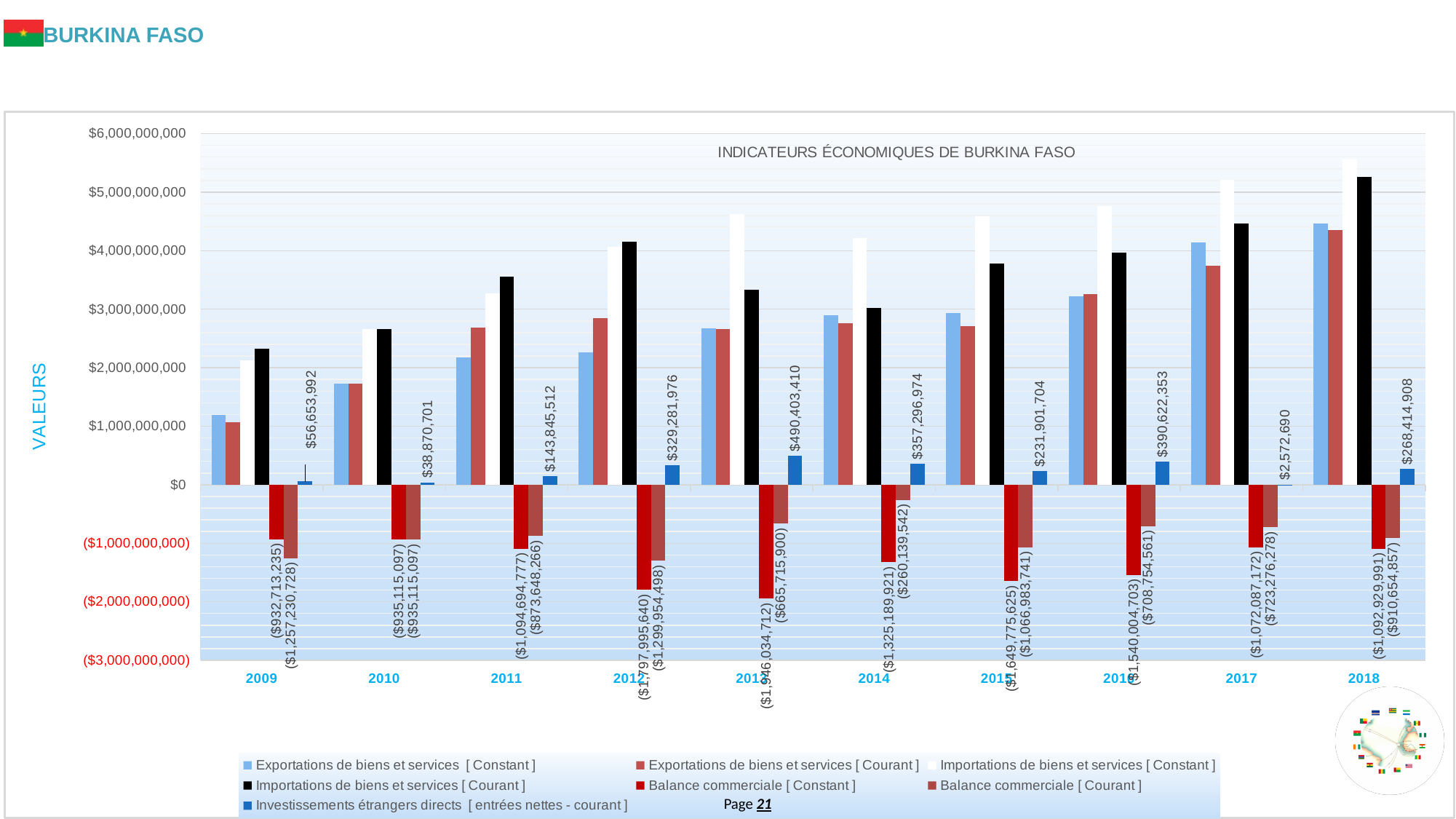
What is the value of Investissements étrangers directs for 2013? $490,403,410 How many years are shown on the x axis? 10 What is the value of Balance commerciale [ Courant ] for 2014? ($260,139,542) In which year is Investissements étrangers directs highest? 2013 Is the value of Importations de biens et services [ Courant ] for 2018 greater or less than $5,000,000,000? greater What is the title of the chart? INDICATEURS ÉCONOMIQUES DE BURKINA FASO What is the difference between Investissements étrangers directs in 2012 and in 2011? $185,436,464 Do the values of Importations de biens et services [ Courant ] generally rise or fall from 2009 to 2018? rise In which year is Investissements étrangers directs lowest? 2017 How many series does the legend list? 7 What kind of chart is shown? bar chart Which year has the larger Investissements étrangers directs value, 2015 or 2016? 2016